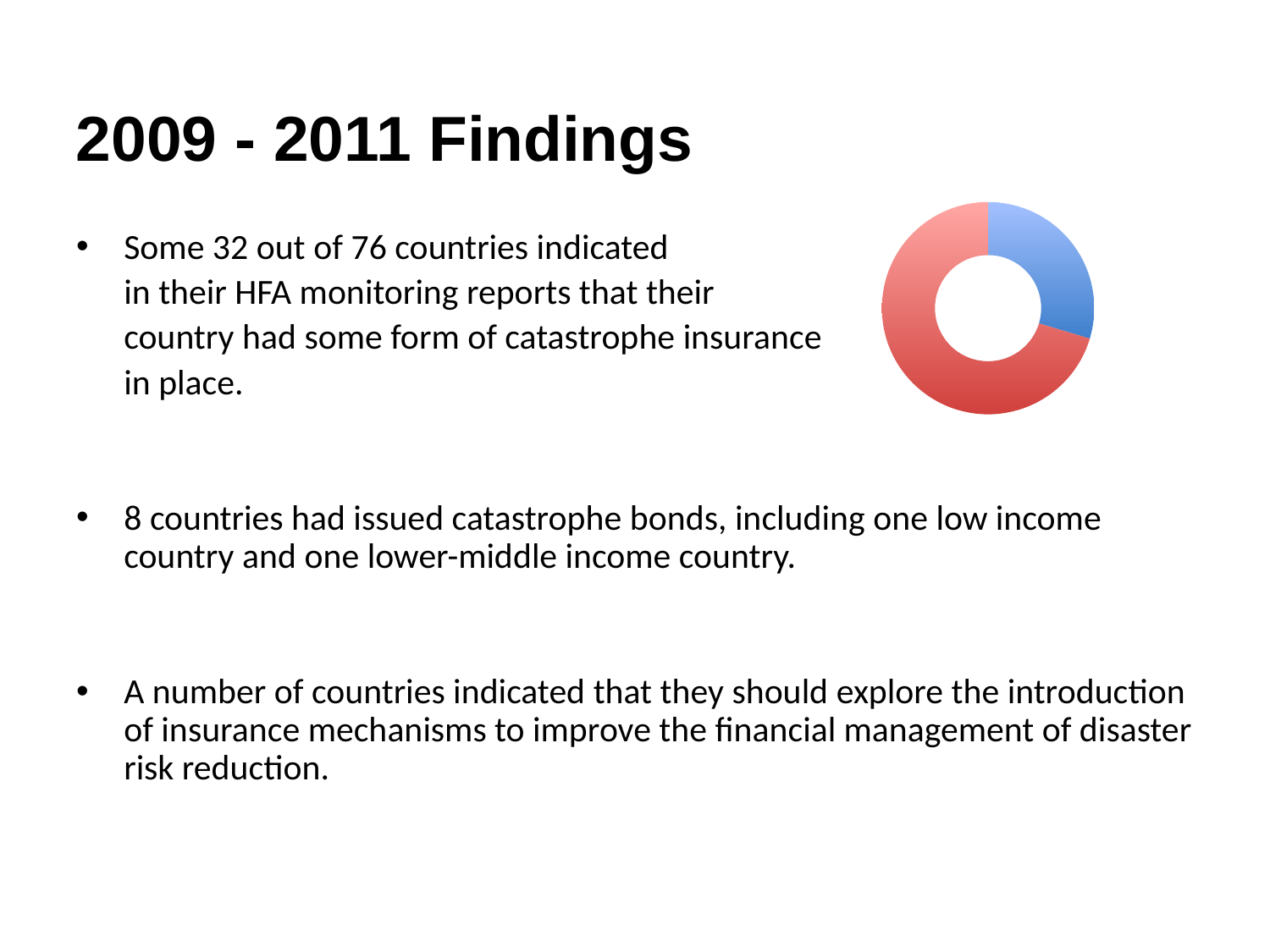
How many slices does the doughnut chart have? 2 Does the doughnut chart on the slide have a legend? No What kind of chart is shown on the slide? Doughnut chart Which slice of the doughnut chart is larger, the blue one or the red one? The red one Which slice of the doughnut chart is the smallest? The blue slice What two colours are used for the slices of the doughnut chart? Blue and red